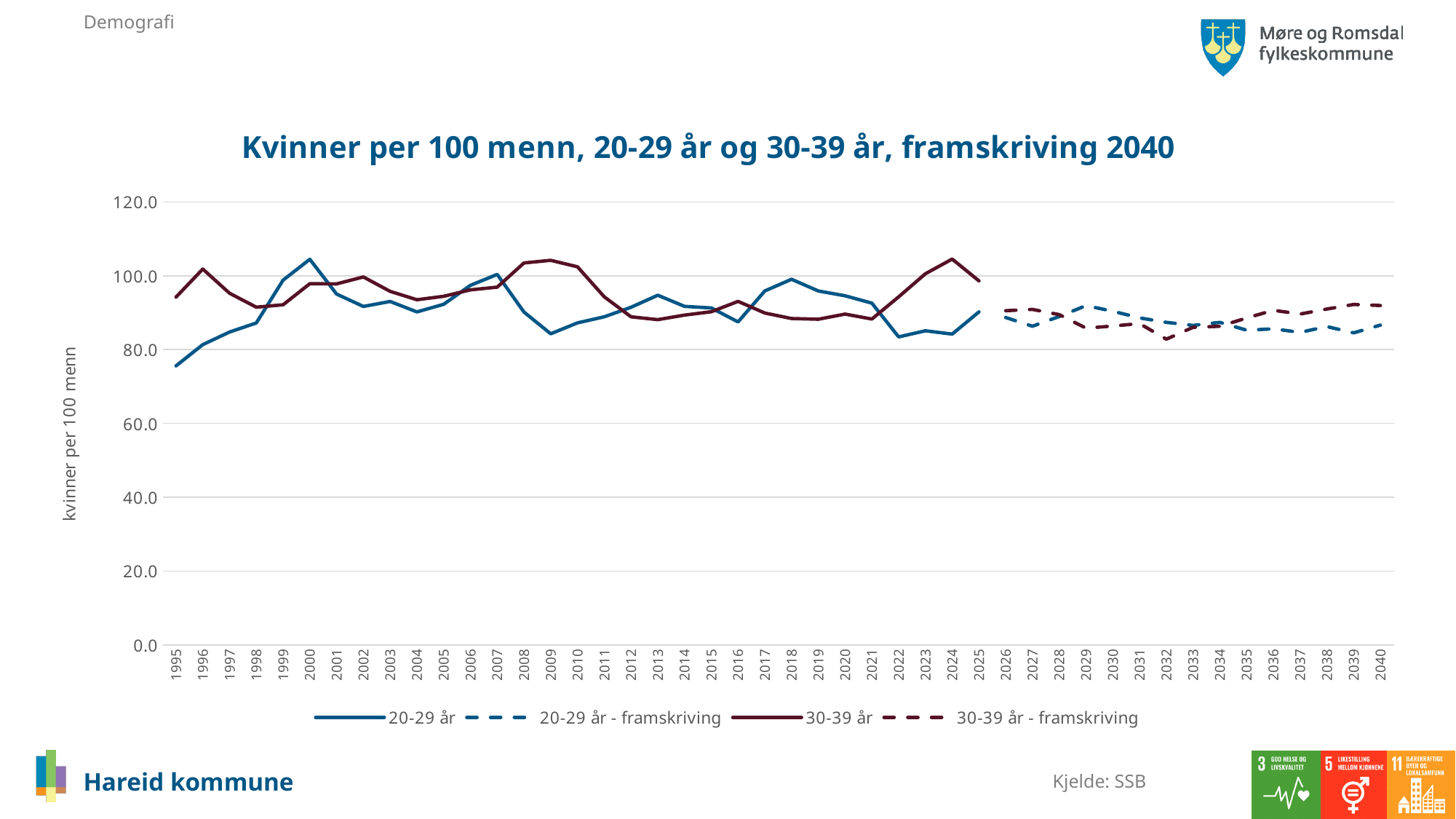
What is the label on the vertical axis? kvinner per 100 menn Is the value for 30-39 år in 2009 greater or less than 100? greater Does the 20-29 år series rise or fall from 1995 to 2000? rise How many series does the legend list? 4 What kind of chart is shown on the slide? line chart In which year does the 20-29 år series reach its lowest value? 1995 Is the value for 20-29 år in 2000 greater or less than 100? greater Is the value for 20-29 år in 2022 greater or less than 90? less In 2000, which series has the higher value, 20-29 år or 30-39 år? 20-29 år What is the title of the chart? Kvinner per 100 menn, 20-29 år og 30-39 år, framskriving 2040 In 1995, which series has the higher value, 20-29 år or 30-39 år? 30-39 år